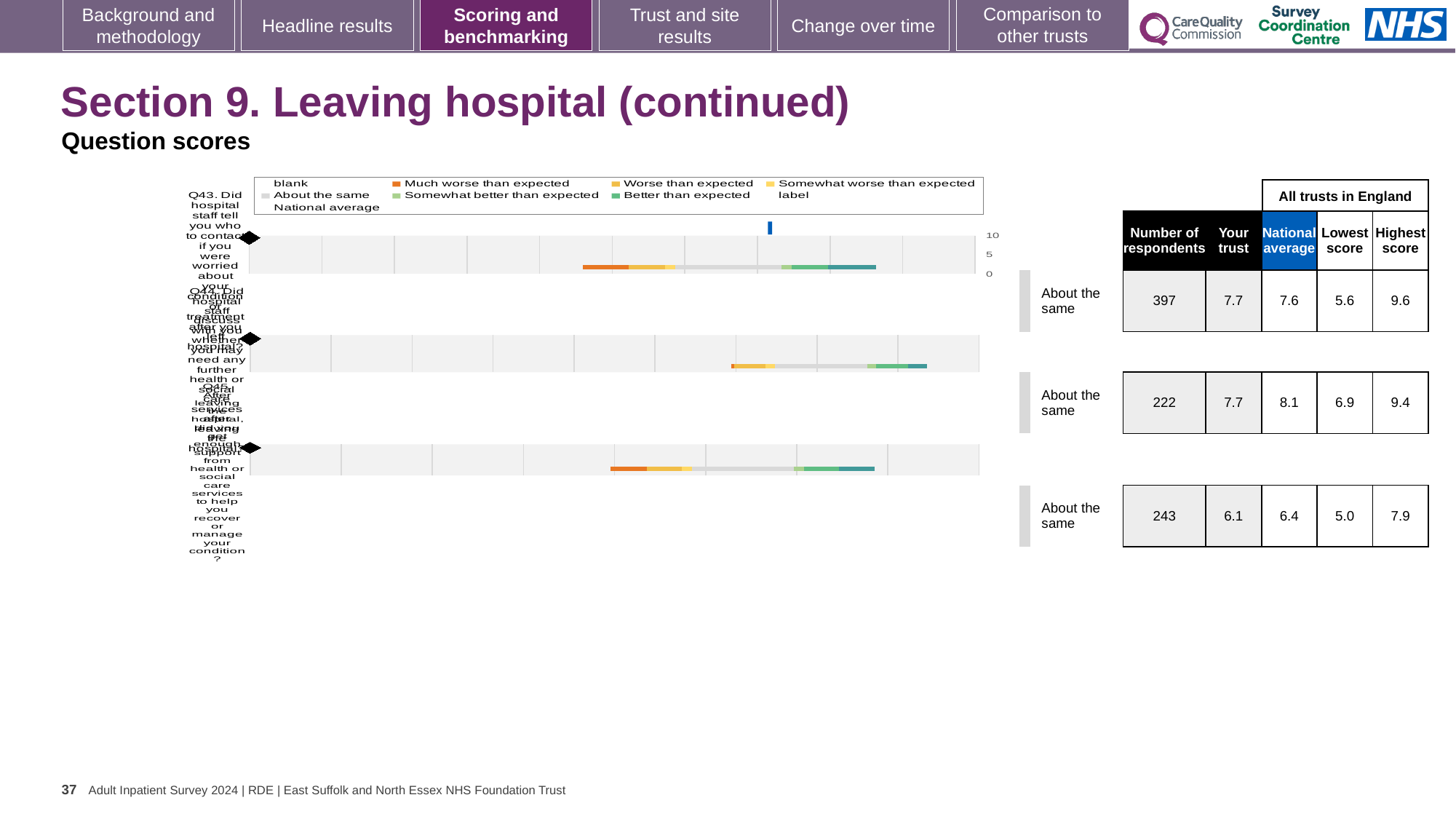
What kind of chart is shown on the slide? bar chart In the table beside the chart, what is the 'Your trust' score for the first row (Q43)? 7.7 In the table beside the chart, is the 'Your trust' score for the second row larger or smaller than its 'National average'? smaller How many horizontal bars are plotted in the chart? 3 What benchmark category label is shown beside the third bar? About the same In the table beside the chart, what is the number of respondents for the second row? 222 What benchmark category label is shown beside the first bar (Q43)? About the same In the table beside the chart, what is the difference between the highest score and the lowest score for the first row (Q43)? 4.0 What is the highest value shown on the chart's axis? 10 In the table beside the chart, which row has the lowest 'Your trust' score? the third row (6.1) Which legend entry is shown in orange? Much worse than expected In the table beside the chart, what is the 'National average' for the third row? 6.4